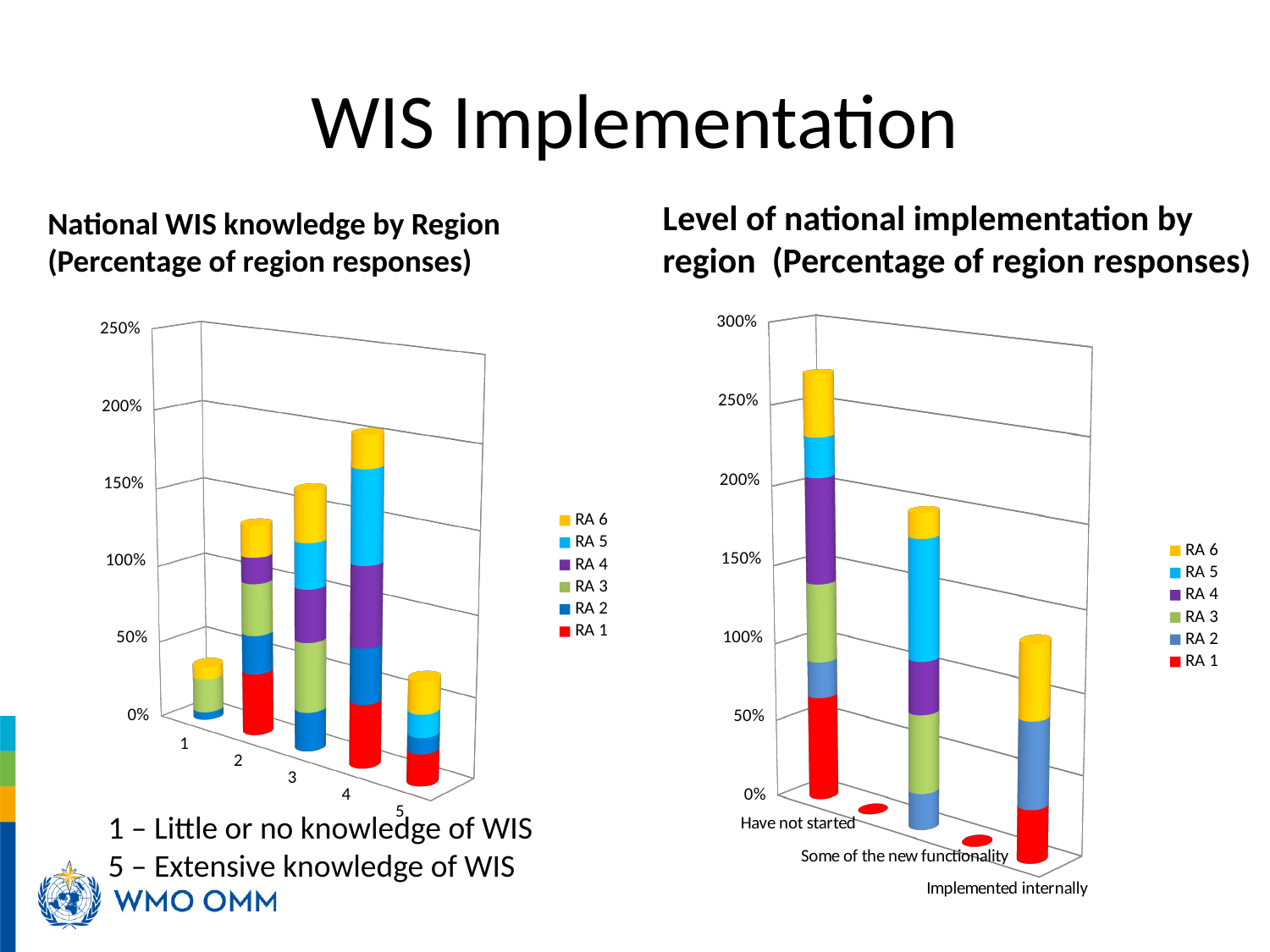
How many series does the legend of the 'National WIS knowledge by Region' chart list? 6 In the 'Level of national implementation by region' chart, is the total stacked value for 'Have not started' greater or less than 200%? greater In the 'Level of national implementation by region' chart, which series is shown in red in the legend? RA 1 How many series does the legend of the 'Level of national implementation by region' chart list? 6 In the 'National WIS knowledge by Region' chart, which category has the tallest stacked bar? 4 In the 'Level of national implementation by region' chart, which category has the tallest stacked bar? Have not started What kind of chart is the 'National WIS knowledge by Region' chart on the left? Stacked bar chart How many categories are shown on the x axis of the 'National WIS knowledge by Region' chart? 5 What kind of chart is the 'Level of national implementation by region' chart on the right? Stacked bar chart In the 'National WIS knowledge by Region' chart, is the total stacked value for category 1 greater or less than 50%? less In the 'National WIS knowledge by Region' chart, which category has the shortest stacked bar? 1